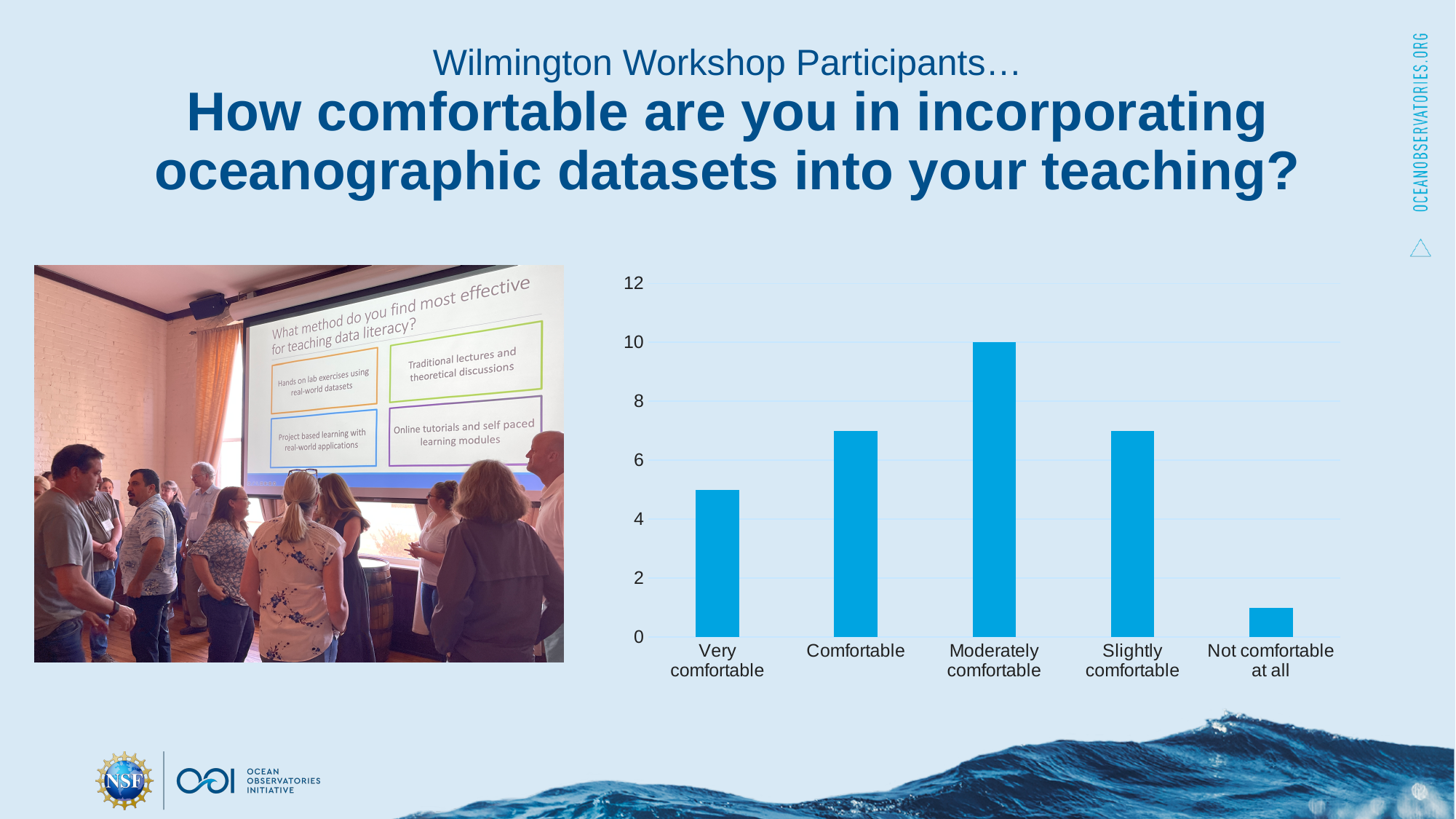
How many categories are shown on the x axis of the chart? 5 Which category has the highest bar? Moderately comfortable Is the value for Comfortable greater or less than 6? greater Is the value for Slightly comfortable greater or less than 8? less Is the value for Not comfortable at all greater or less than 2? less Which is larger, the value for Very comfortable or the value for Comfortable? Comfortable What kind of chart is shown on the slide? bar chart Which category has the lowest bar? Not comfortable at all What is the value for Moderately comfortable? 10 What is the highest value shown on the chart's vertical axis? 12